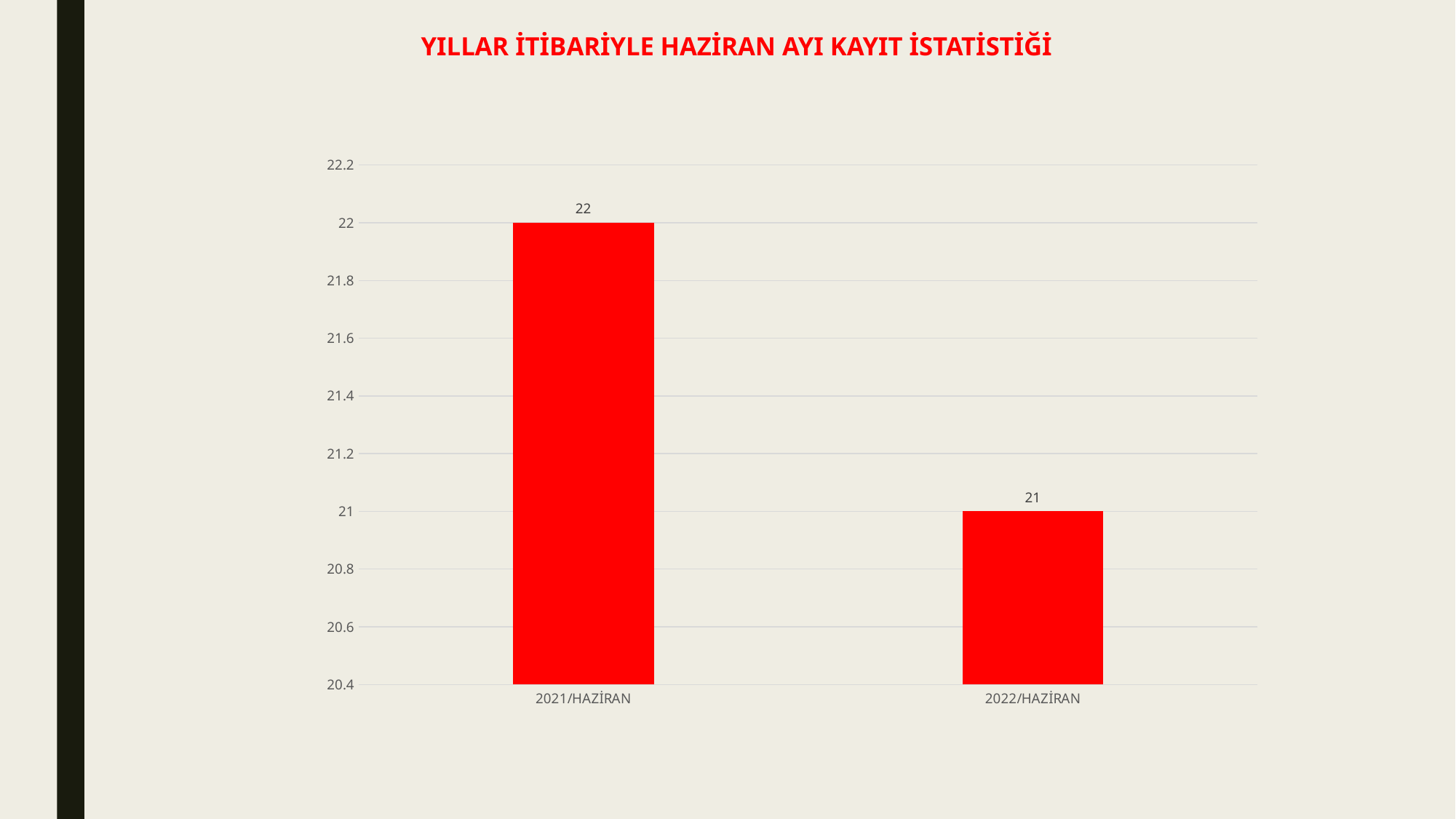
What kind of chart is shown on the slide? bar chart What is the value for 2021/HAZİRAN? 22 Is the value for 2022/HAZİRAN greater or less than 21.4? less Which is larger, the value for 2021/HAZİRAN or the value for 2022/HAZİRAN? 2021/HAZİRAN Do the values rise or fall from 2021/HAZİRAN to 2022/HAZİRAN? fall What is the title of the slide? YILLAR İTİBARİYLE HAZİRAN AYI KAYIT İSTATİSTİĞİ Which category has the highest value? 2021/HAZİRAN What is the difference between the values for 2021/HAZİRAN and 2022/HAZİRAN? 1 How many categories are shown on the x axis? 2 Which category has the lowest value? 2022/HAZİRAN What is the value for 2022/HAZİRAN? 21 Is the value for 2021/HAZİRAN greater or less than 21.6? greater